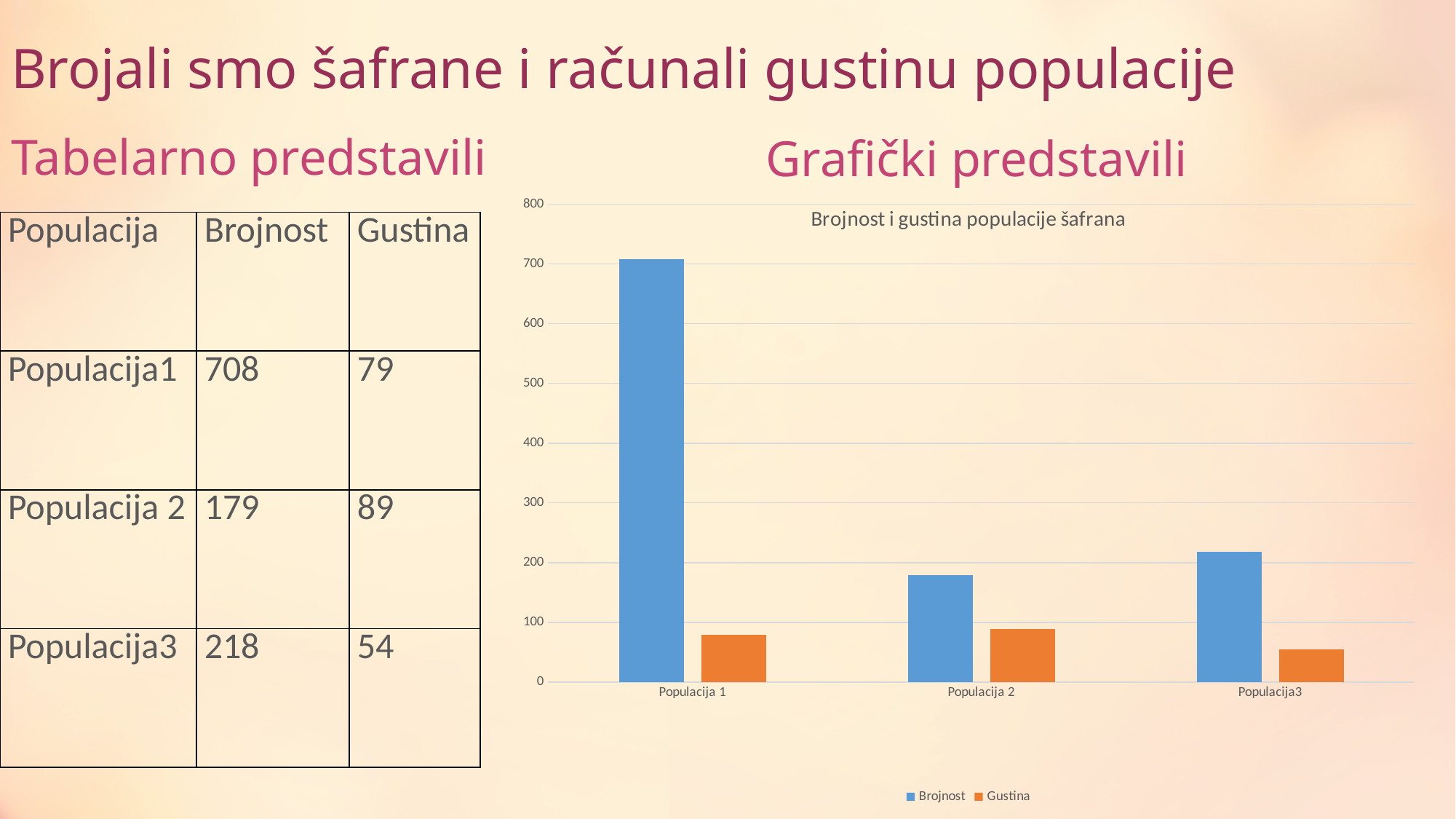
Is the Gustina value for Populacija3 greater or less than 100? less Is the Brojnost value for Populacija 2 greater or less than 200? less How many populations (categories) are shown on the x axis of the chart? 3 According to the slide, what is the Brojnost value for Populacija1? 708 What type of chart is shown on the slide? bar chart What is the title of the chart? Brojnost i gustina populacije šafrana How many series does the chart legend list? 2 Which is larger: the Brojnost value for Populacija3 or the Brojnost value for Populacija 2? Populacija3 Is the Brojnost value for Populacija 1 greater or less than 700? greater Which colour represents the Gustina series in the chart? orange Which population has the lowest Gustina value in the chart? Populacija3 Which population has the highest Brojnost value in the chart? Populacija 1